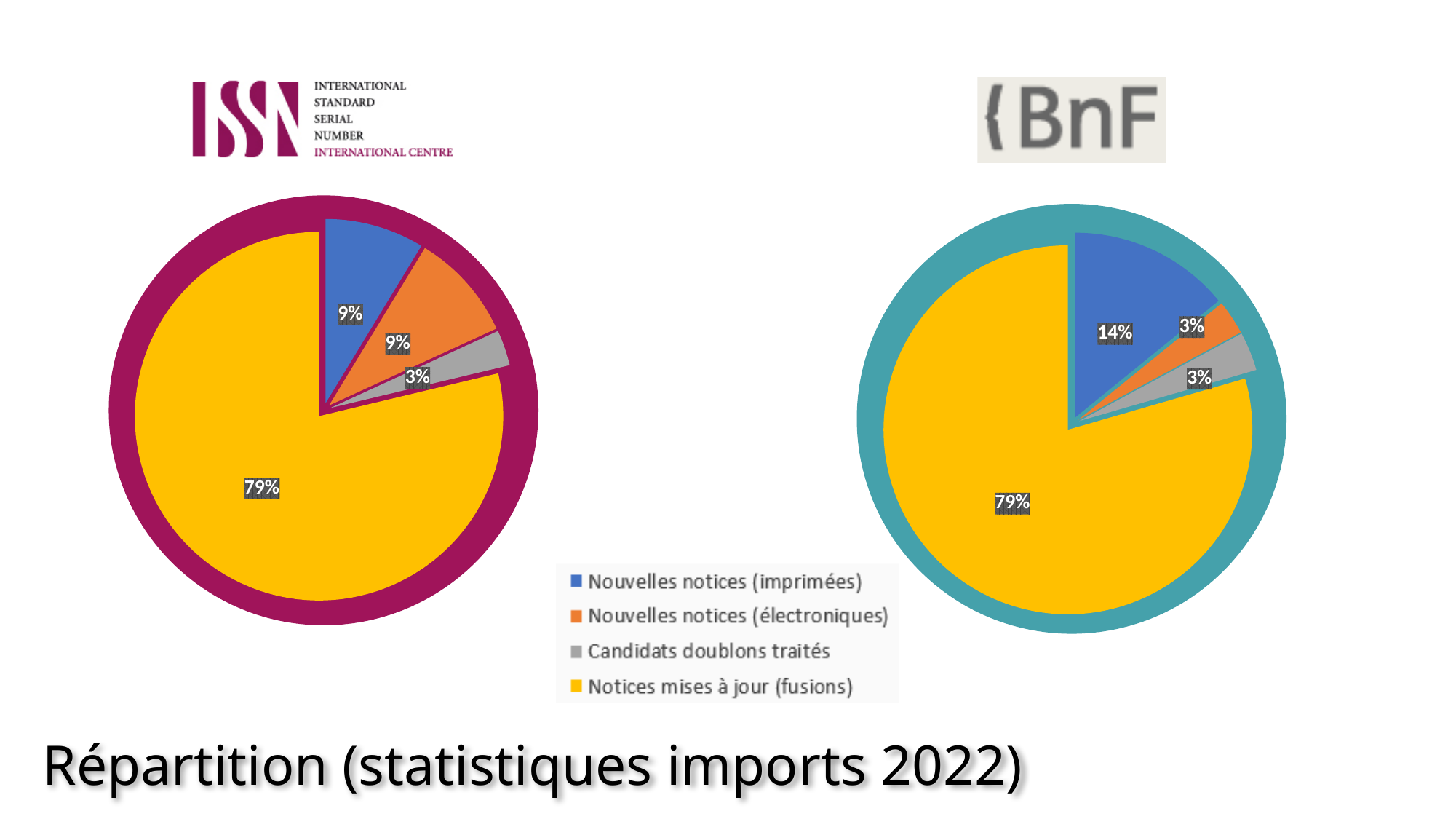
In the left pie chart (ISSN International Centre), which category has the smallest slice? Candidats doublons traités In the left pie chart (ISSN International Centre), what share is labelled for Notices mises à jour (fusions)? 79% What kind of charts are shown on the slide? Pie charts How many categories does the legend list? 4 In the right pie chart (BnF), what share is labelled for Nouvelles notices (électroniques)? 3% Which chart has the larger share for Nouvelles notices (imprimées), the left (ISSN) pie or the right (BnF) pie? The right (BnF) pie In the left pie chart (ISSN International Centre), what share is labelled for Nouvelles notices (imprimées)? 9% In the right pie chart (BnF), what is the difference between the share for Nouvelles notices (imprimées) and the share for Nouvelles notices (électroniques)? 11% In the right pie chart (BnF), which category has the largest slice? Notices mises à jour (fusions) What colour represents Notices mises à jour (fusions) in the legend? Yellow